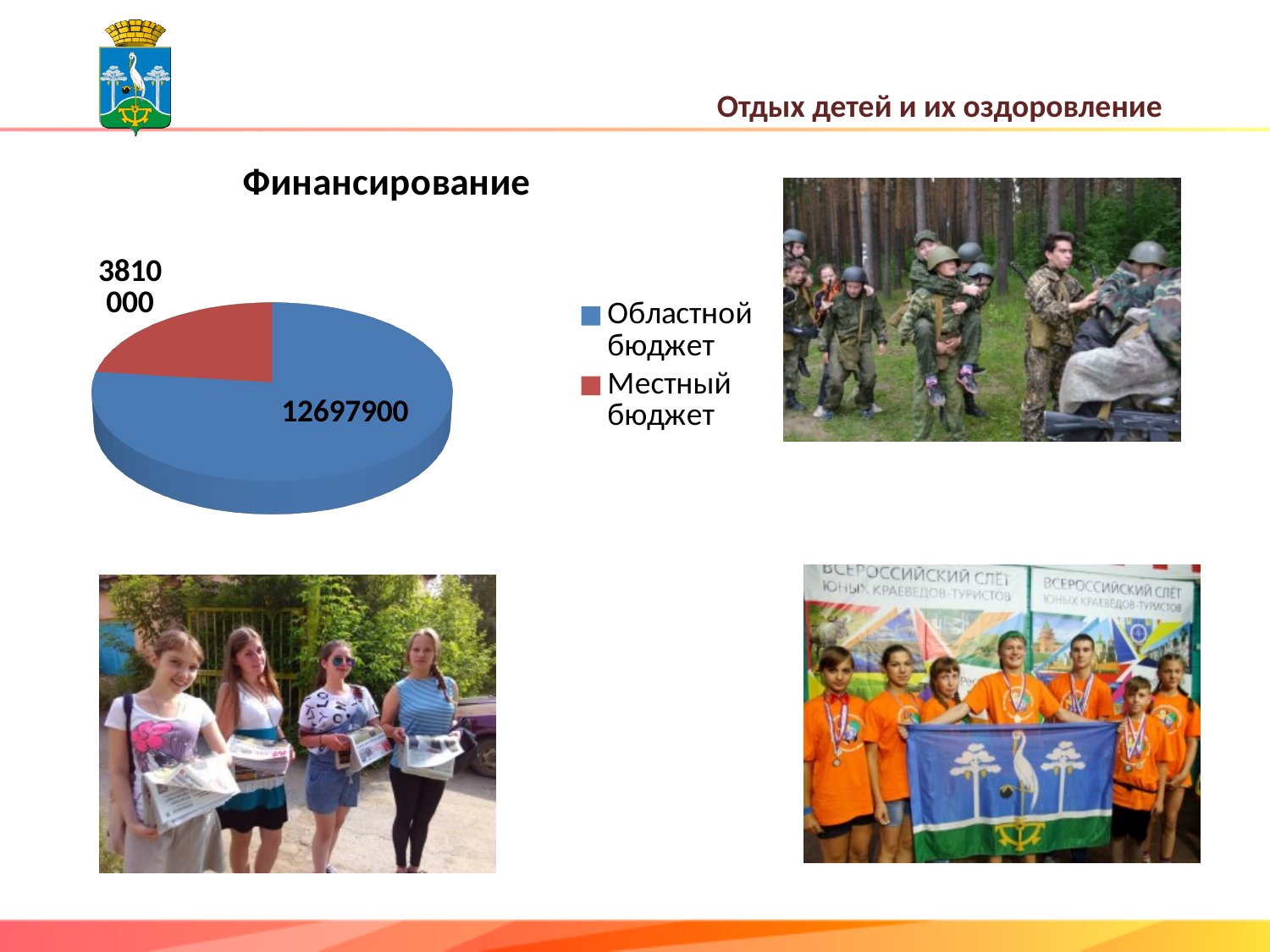
What is the value for Местный бюджет in the pie chart? 3810000 Which slice of the pie chart is the smallest? Местный бюджет How many slices does the pie chart have? 2 What colour is the Местный бюджет slice in the pie chart? red What is the title of the pie chart? Финансирование Which slice of the pie chart is the largest? Областной бюджет What is the value for Областной бюджет in the pie chart? 12697900 Which is larger in the pie chart, Областной бюджет or Местный бюджет? Областной бюджет How many entries does the legend of the pie chart list? 2 What is the total of the two values shown in the pie chart? 16507900 What is the difference between the Областной бюджет and Местный бюджет values in the pie chart? 8887900 What kind of chart is shown on the slide? pie chart